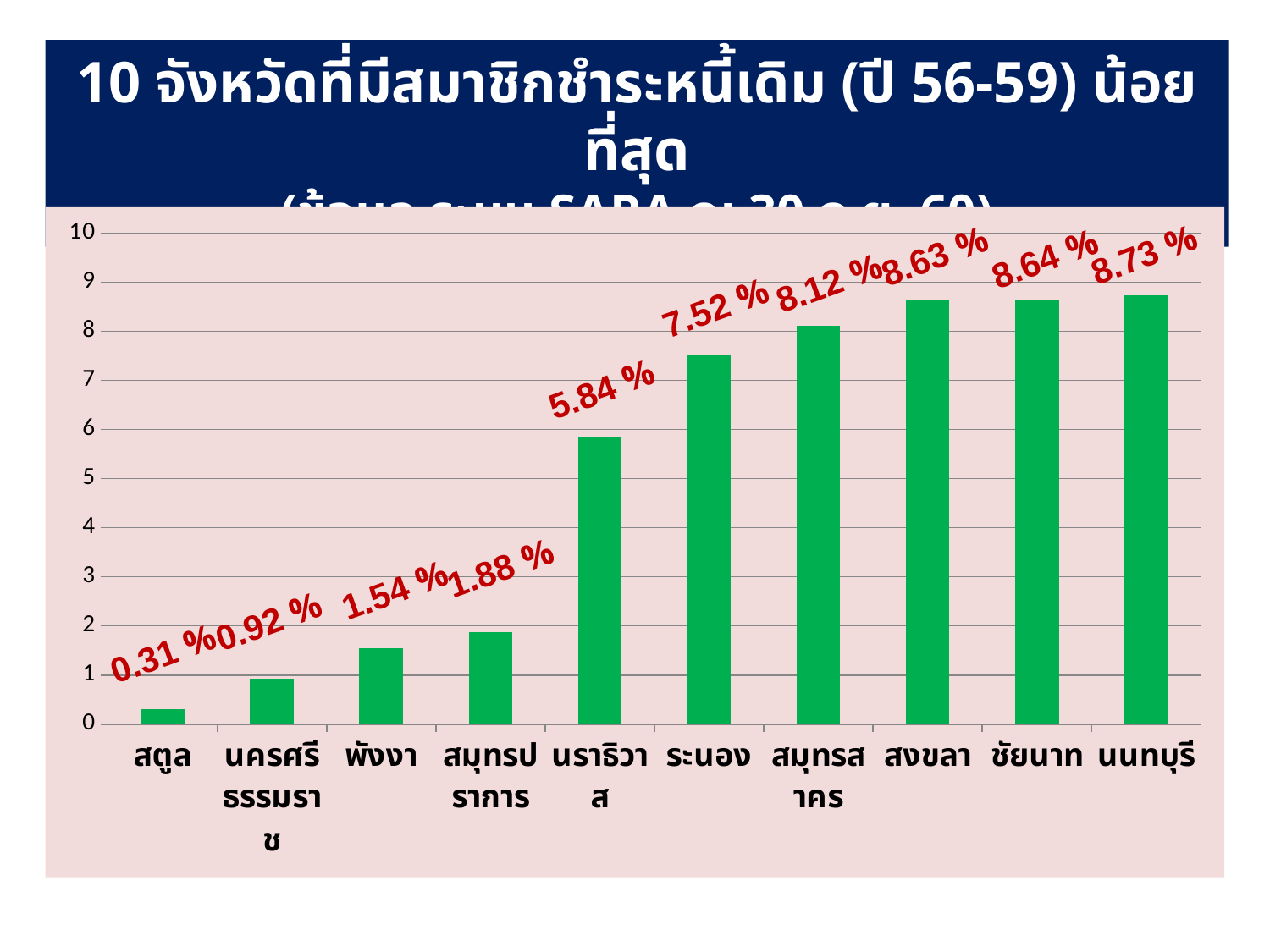
What is the value for สมุทรปราการ? 1.88 % What kind of chart is shown on the slide? Bar chart What is the difference between the values for ระนอง and นราธิวาส? 1.68 % What is the value for สตูล? 0.31 % Which is larger, the value for พังงา or the value for สมุทรสาคร? สมุทรสาคร How many provinces are shown in the chart? 10 Do the values rise or fall from left to right along the x axis? Rise What is the value for ระนอง? 7.52 % Which province has the highest value? นนทบุรี What is the difference between the values for นนทบุรี and สตูล? 8.42 % Which province has the lowest value? สตูล What is the value for นราธิวาส? 5.84 %